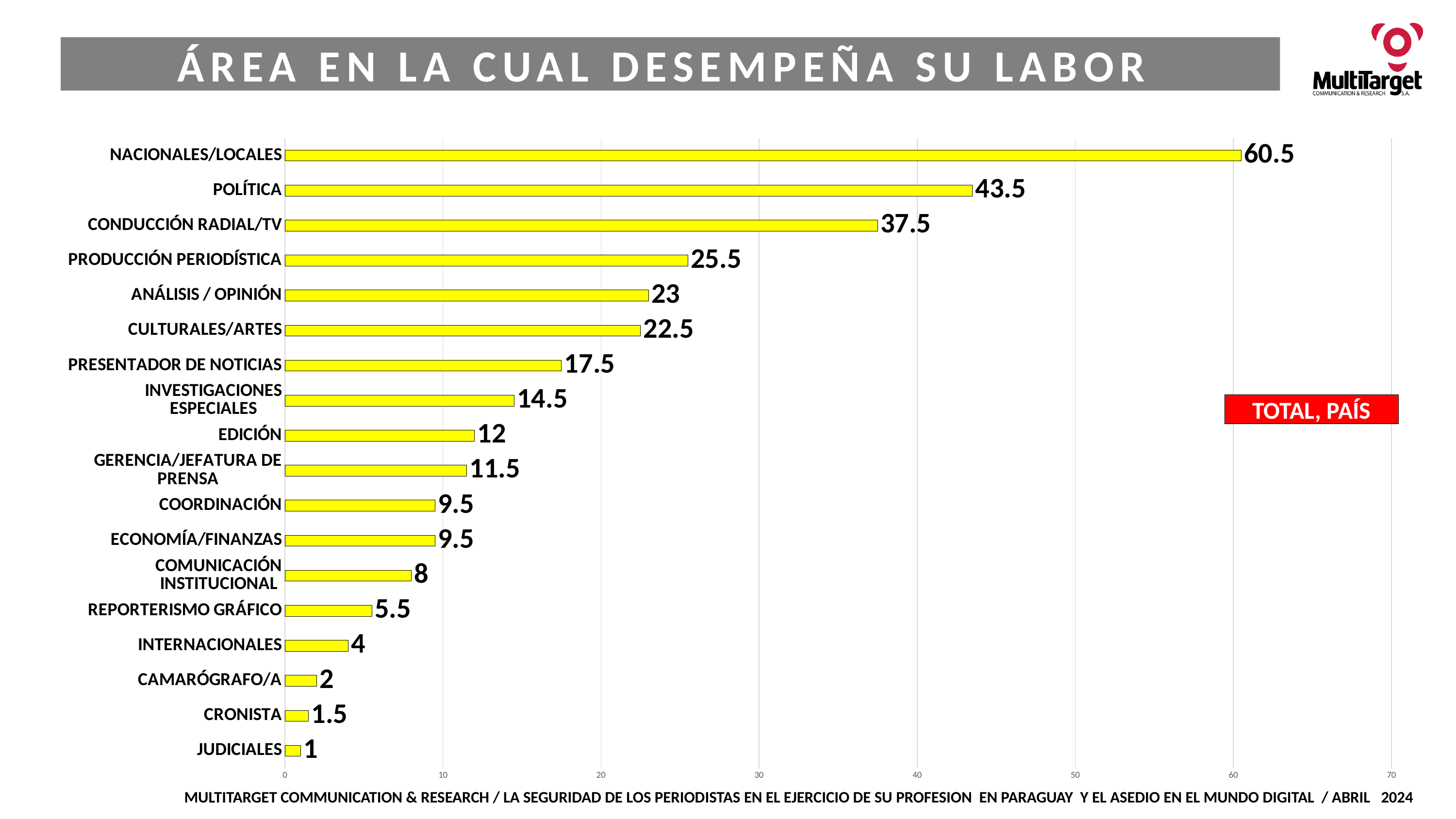
What kind of chart is shown on the slide? bar chart Which category has the lowest value? JUDICIALES What is the difference between the values for PRODUCCIÓN PERIODÍSTICA and ANÁLISIS / OPINIÓN? 2.5 What is the difference between the values for NACIONALES/LOCALES and POLÍTICA? 17 What is the title of the slide? ÁREA EN LA CUAL DESEMPEÑA SU LABOR What is the value for POLÍTICA? 43.5 Which is larger, the value for CONDUCCIÓN RADIAL/TV or the value for CULTURALES/ARTES? CONDUCCIÓN RADIAL/TV Is the value for EDICIÓN greater or less than 10? greater What is the value for PRESENTADOR DE NOTICIAS? 17.5 What is the value for REPORTERISMO GRÁFICO? 5.5 How many categories are shown in the chart? 18 Which category has the highest value? NACIONALES/LOCALES